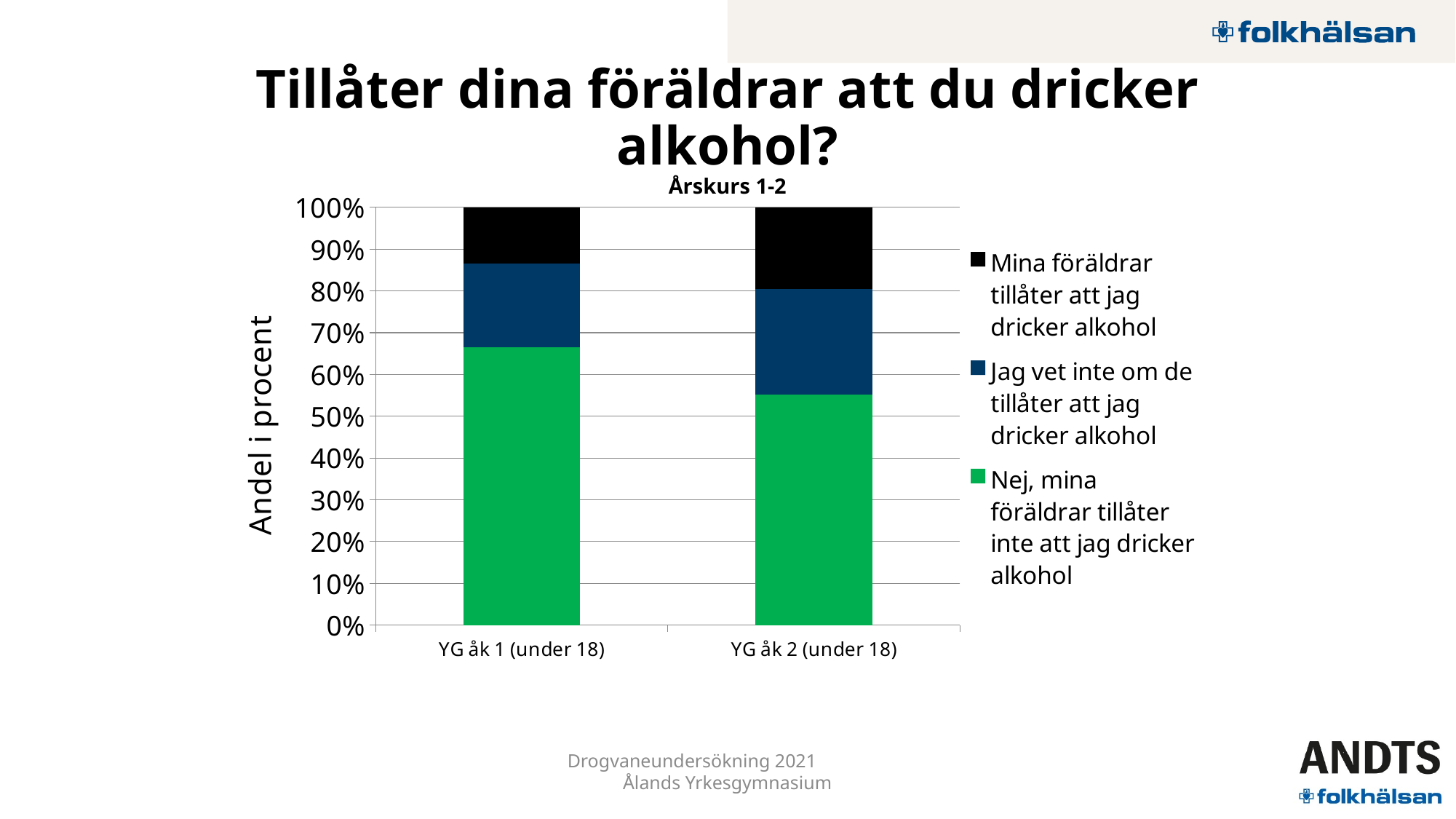
What is the title shown directly above the chart? Årskurs 1-2 Which series makes up the largest segment of the bar for YG åk 2 (under 18)? Nej, mina föräldrar tillåter inte att jag dricker alkohol Is the value for "Nej, mina föräldrar tillåter inte att jag dricker alkohol" for YG åk 1 (under 18) greater or less than 60%? greater How many categories are shown on the x axis of the chart? 2 Which category has the larger share for "Nej, mina föräldrar tillåter inte att jag dricker alkohol": YG åk 1 (under 18) or YG åk 2 (under 18)? YG åk 1 (under 18) What kind of chart is shown on the slide? Stacked bar chart Is the value for "Nej, mina föräldrar tillåter inte att jag dricker alkohol" for YG åk 2 (under 18) greater or less than 60%? less What is the label of the vertical axis? Andel i procent Does the share for "Nej, mina föräldrar tillåter inte att jag dricker alkohol" rise or fall from YG åk 1 (under 18) to YG åk 2 (under 18)? fall Is the value for "Mina föräldrar tillåter att jag dricker alkohol" for YG åk 1 (under 18) greater or less than 20%? less How many series does the chart's legend list? 3 Which category has the larger share for "Mina föräldrar tillåter att jag dricker alkohol": YG åk 1 (under 18) or YG åk 2 (under 18)? YG åk 2 (under 18)